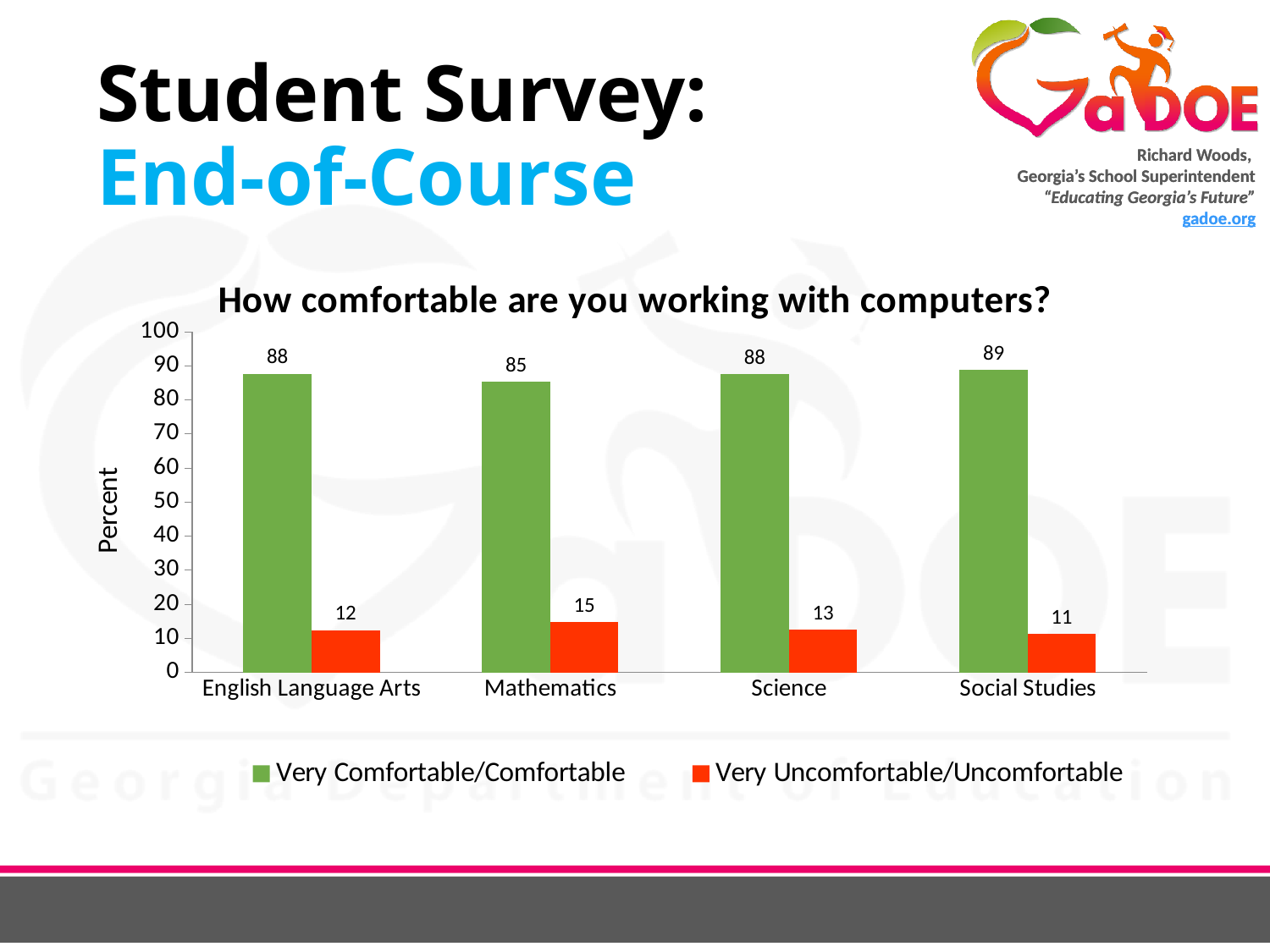
How many subjects are shown on the x axis? 4 Which subject has the lowest Very Comfortable/Comfortable value? Mathematics What is the difference between the Very Comfortable/Comfortable and Very Uncomfortable/Uncomfortable values for English Language Arts? 76 What is the Very Uncomfortable/Uncomfortable value for Science? 13 What is the title of the chart? How comfortable are you working with computers? What is the Very Comfortable/Comfortable value for Mathematics? 85 What kind of chart is shown on the slide? Bar chart Which subject has the highest Very Comfortable/Comfortable value? Social Studies Which subject has the highest Very Uncomfortable/Uncomfortable value? Mathematics Which is larger: the Very Uncomfortable/Uncomfortable value for Mathematics or for Social Studies? Mathematics What is the Very Uncomfortable/Uncomfortable value for Social Studies? 11 How many series does the legend list? 2